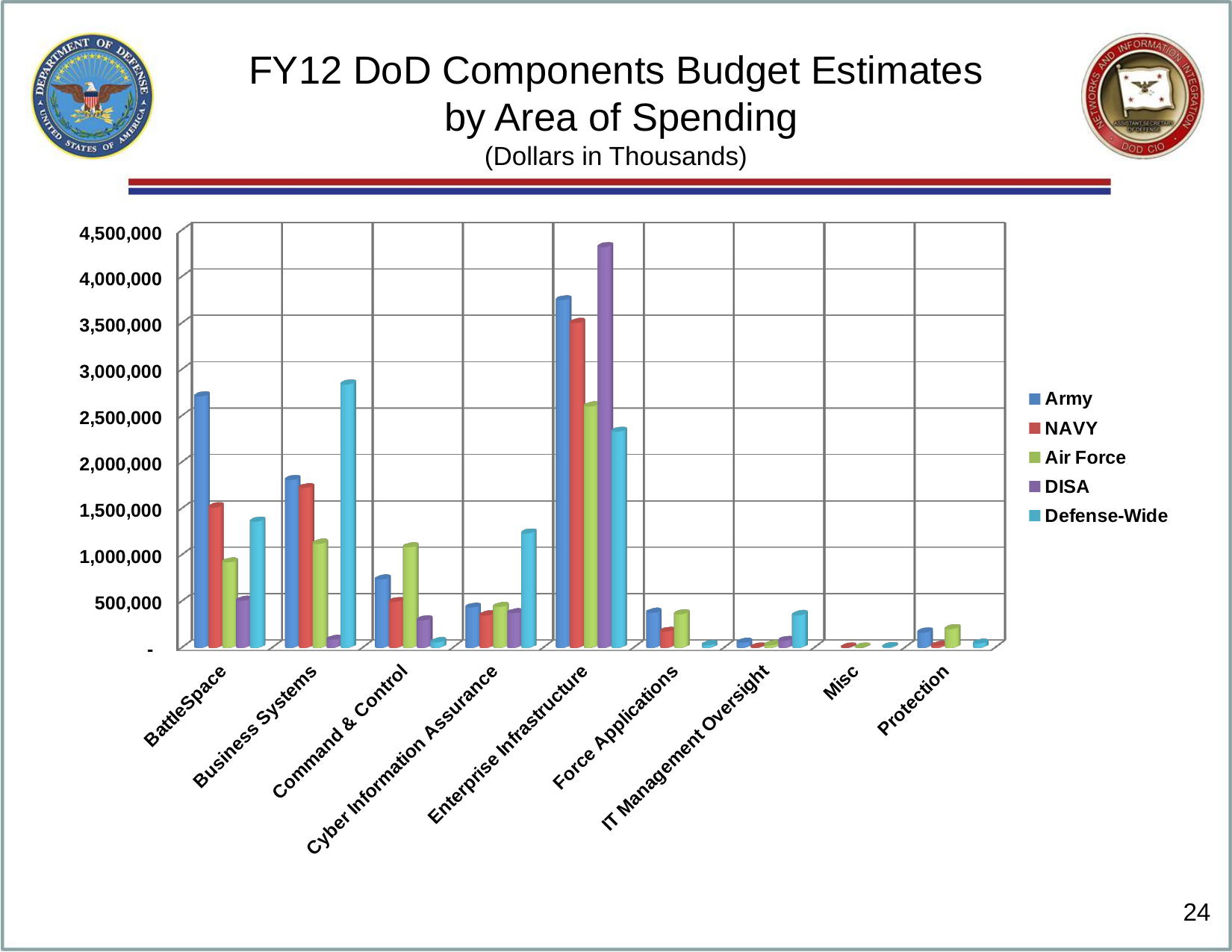
Is the Army value for BattleSpace greater or less than 2,500,000? greater How many series does the legend list? 5 Is the NAVY value for Enterprise Infrastructure greater or less than 3,000,000? greater How many spending areas are shown along the x axis? 9 Which component has the highest value for BattleSpace? Army What kind of chart is shown on the slide? Bar chart In which area of spending is the DISA bar the tallest? Enterprise Infrastructure Is the Defense-Wide value for Business Systems greater or less than 2,500,000? greater Which component has the lowest value for Business Systems? DISA For Business Systems, which is larger: the Defense-Wide value or the Army value? Defense-Wide For Enterprise Infrastructure, which is larger: the DISA value or the Army value? DISA